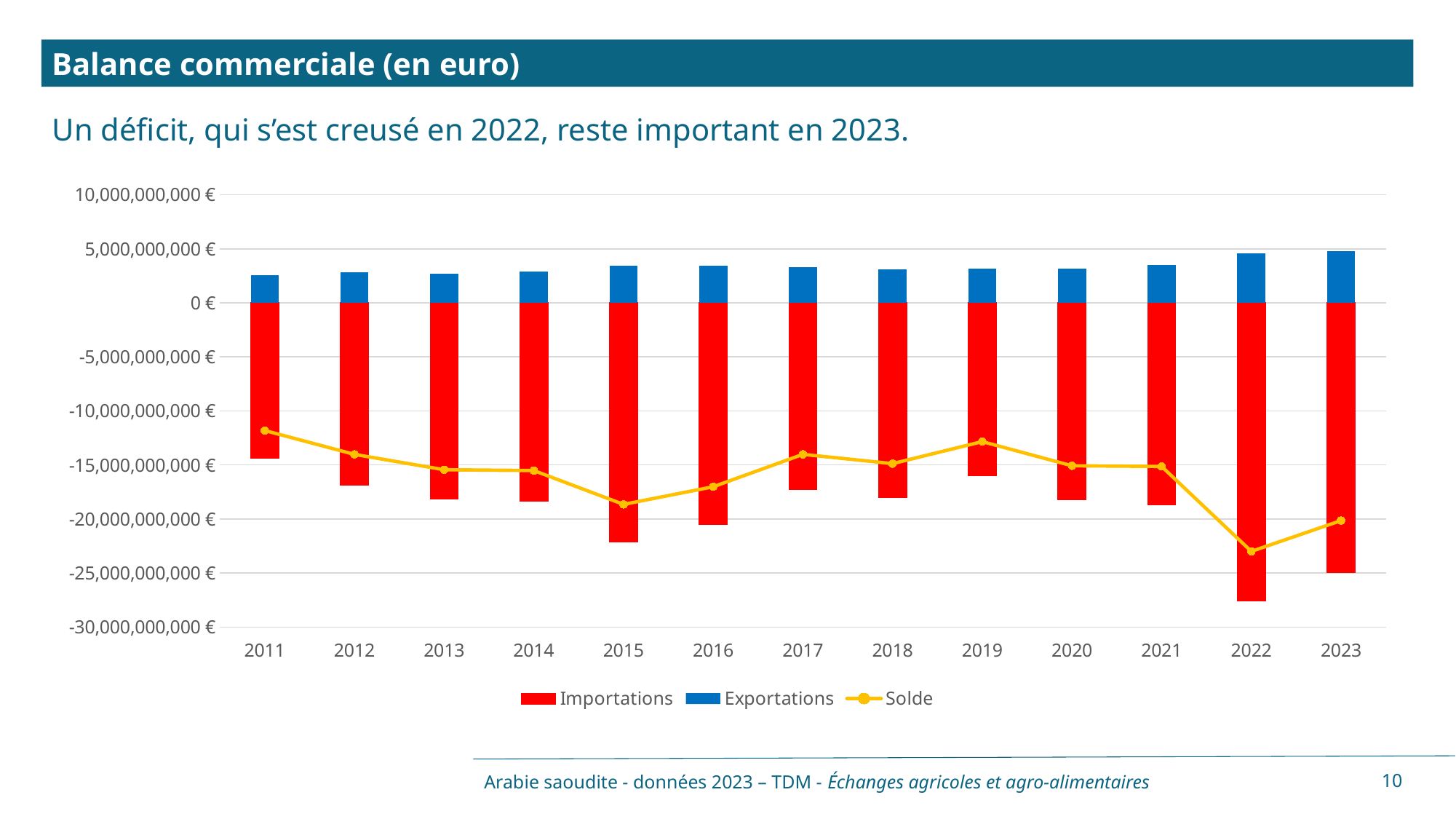
In which year does the Solde line reach its lowest point? 2022 Which year has the larger Importations bar, 2015 or 2016? 2015 What kind of chart is shown on the slide? A bar chart combined with a line Is the Solde value for 2015 greater or less than -15,000,000,000 €? less Which series is drawn as a yellow line with markers? Solde What is the title of the chart? Balance commerciale (en euro) Is the Importations value for 2022 greater or less than -25,000,000,000 €? less How many years are shown on the x axis of the chart? 13 In which year is the Importations bar the longest (largest imports)? 2022 In which year is the Importations bar the shortest (smallest imports)? 2011 How many series does the chart legend list? 3 Does the Solde line rise or fall from 2021 to 2022? fall